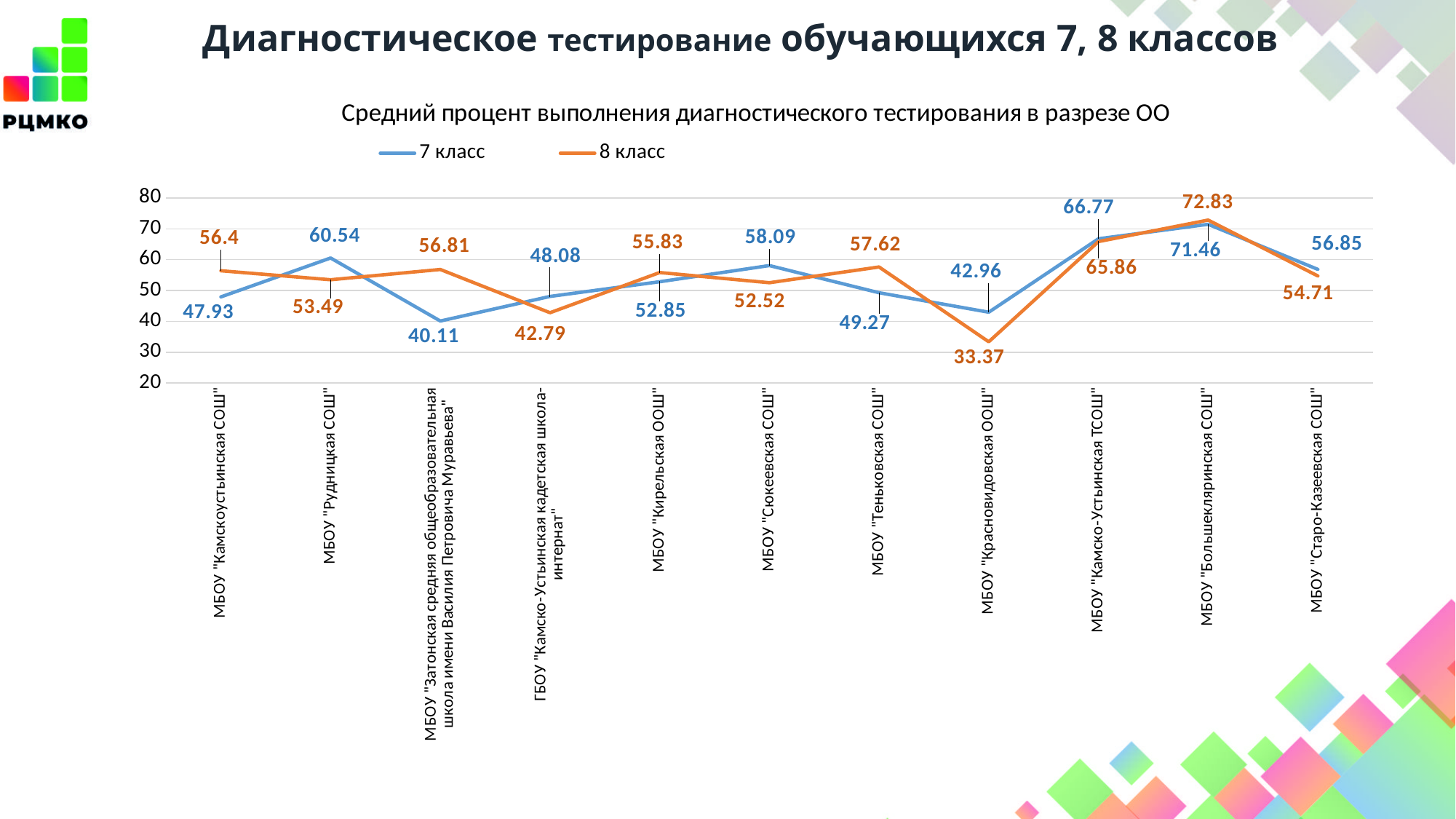
What is the value for 7 класс at ГБОУ "Камско-Устьинская кадетская школа-интернат"? 48.08 How many schools (categories) are plotted on the x axis? 11 At МБОУ "Сюкеевская СОШ", which is larger: the 7 класс value or the 8 класс value? 7 класс Which school has the lowest value for 8 класс? МБОУ "Красновидовская ООШ" What is the value for 8 класс at МБОУ "Теньковская СОШ"? 57.62 How many series does the legend list? 2 What is the value for 7 класс at МБОУ "Рудницкая СОШ"? 60.54 Which school has the lowest value for 7 класс? МБОУ "Затонская средняя общеобразовательная школа имени Василия Петровича Муравьева" What type of chart is shown on the slide? line chart Which school has the highest value for 8 класс? МБОУ "Большекляринская СОШ" What is the difference between the 7 класс and 8 класс values at МБОУ "Красновидовская ООШ"? 9.59 What is the title of the chart? Средний процент выполнения диагностического тестирования в разрезе ОО